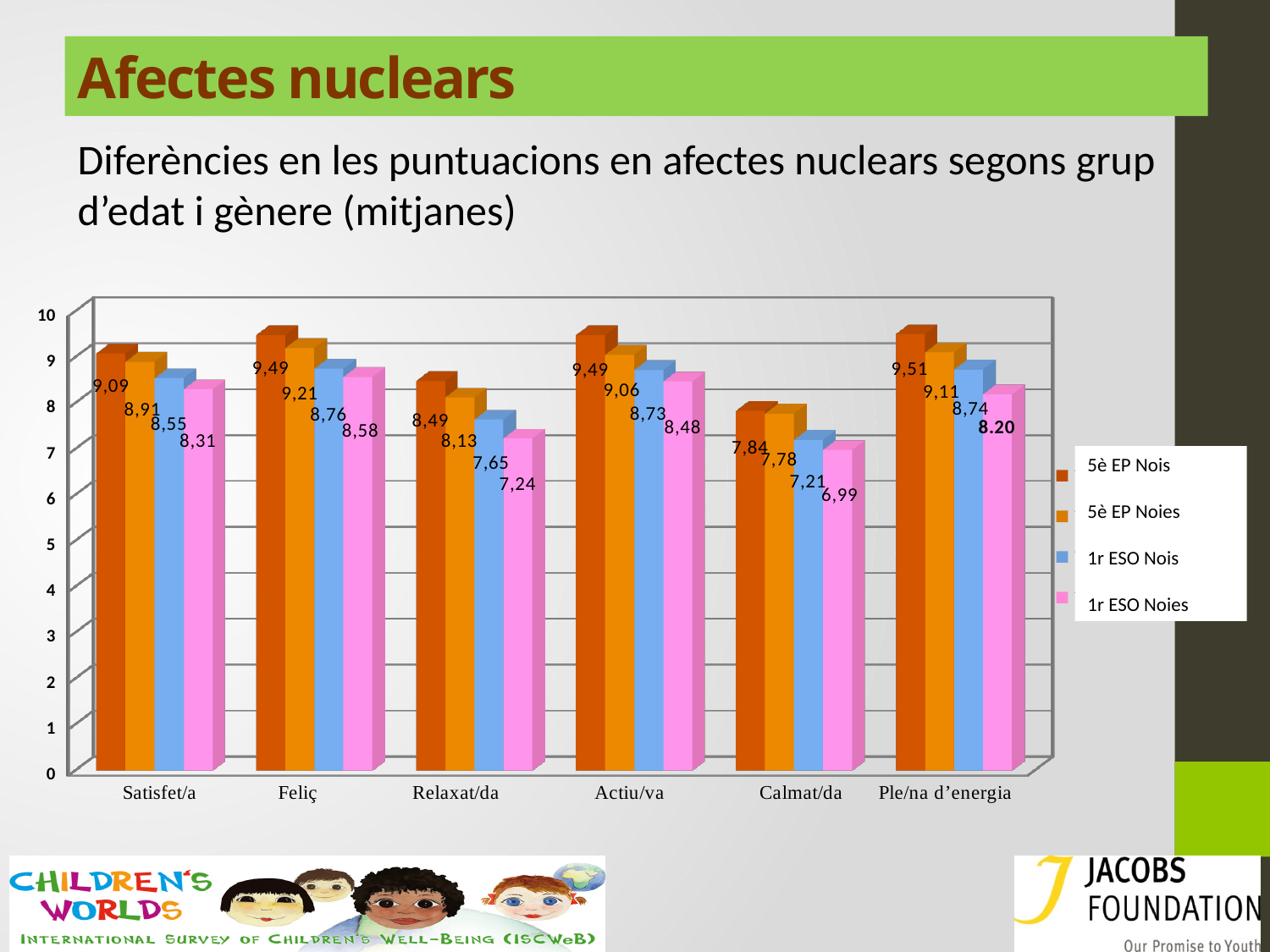
How many categories are shown on the x axis of the chart? 6 What is the value for 5è EP Noies in the Feliç category? 9,21 Which is larger: the 5è EP Nois value for Feliç or the 5è EP Nois value for Relaxat/da? Feliç What is the difference between the 5è EP Nois and 1r ESO Noies values in the Satisfet/a category? 0,78 How many series does the legend list? 4 Which category has the lowest value for the 1r ESO Noies series? Calmat/da Is the value for 5è EP Nois in the Calmat/da category greater or less than 8? less What is the value for 1r ESO Nois in the Relaxat/da category? 7,65 What is the value for 1r ESO Noies in the Calmat/da category? 6,99 What kind of chart is shown on the slide? bar chart Which category has the lowest value for the 5è EP Nois series? Calmat/da What is the value for 5è EP Nois in the Satisfet/a category? 9,09